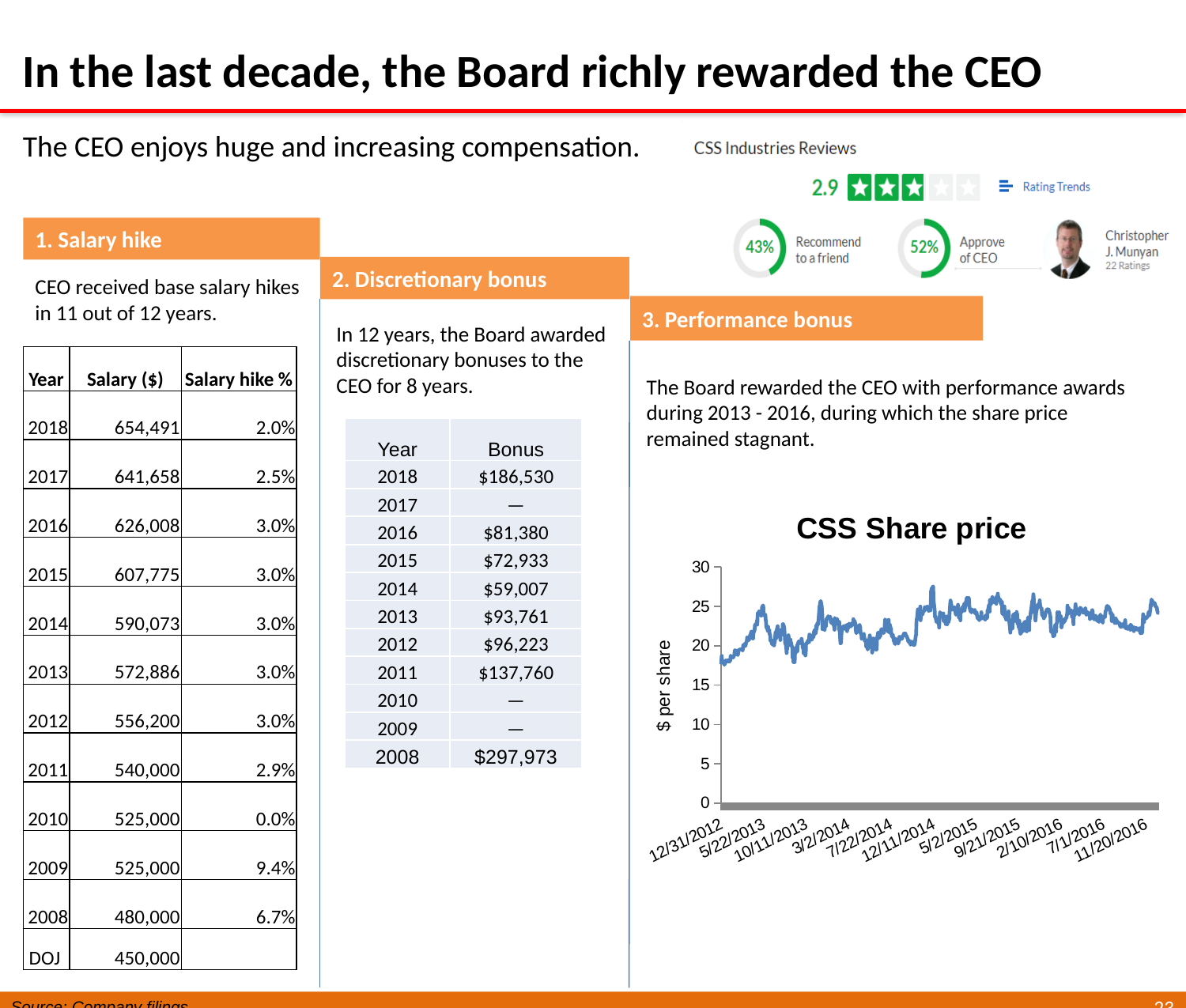
In the CSS Share price chart, is the value around 3/2/2014 greater or less than 25? less How many data series are plotted in the CSS Share price chart? 1 How many date labels are shown on the x axis of the CSS Share price chart? 11 In the CSS Share price chart, is the value at 12/31/2012 greater or less than 20? less In the CSS Share price chart, is the lowest share price reached greater or less than 15? greater What is the title of the chart on the slide? CSS Share price What is the label on the vertical axis of the CSS Share price chart? $ per share In the CSS Share price chart, does the share price overall rise or fall from 12/31/2012 to 11/20/2016? rise What kind of chart is the CSS Share price chart? line chart